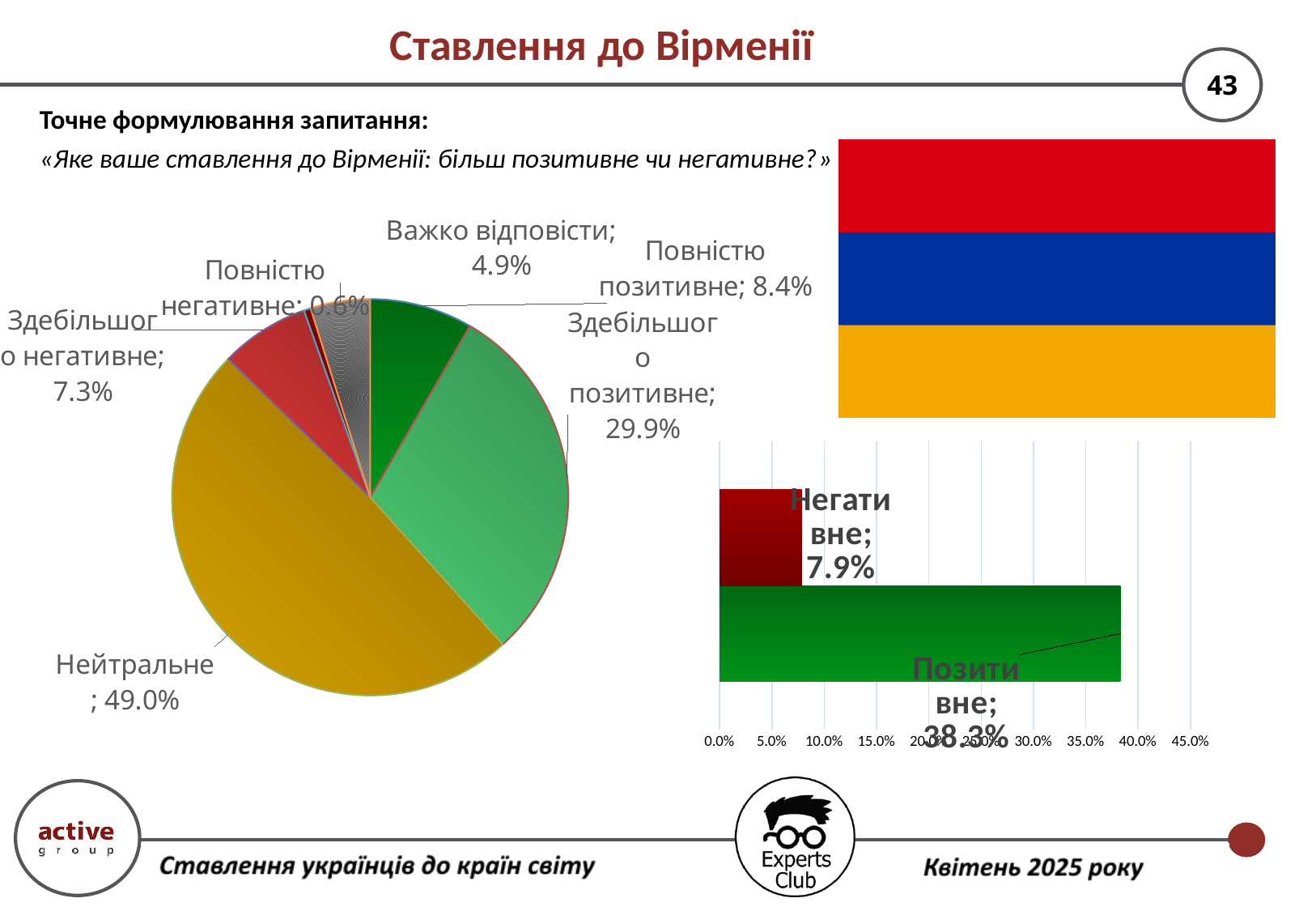
In the pie chart, what share of respondents answered "Повністю негативне"? 0.6% In the pie chart, how many categories are shown? 6 What type of chart is shown at the bottom right of the slide? Bar chart In the pie chart, which is larger: "Повністю позитивне" or "Здебільшого негативне"? Повністю позитивне In the pie chart, what is the difference between "Здебільшого позитивне" and "Повністю позитивне"? 21.5% In the pie chart, which category has the largest share? Нейтральне In the bar chart at the bottom right, what is the value for "Позитивне"? 38.3% In the pie chart, which category has the smallest share? Повністю негативне In the pie chart, what share of respondents answered "Нейтральне"? 49.0% In the bar chart at the bottom right, what is the difference between "Позитивне" and "Негативне"? 30.4% In the pie chart, what share of respondents answered "Здебільшого позитивне"? 29.9% In the bar chart at the bottom right, what is the value for "Негативне"? 7.9%